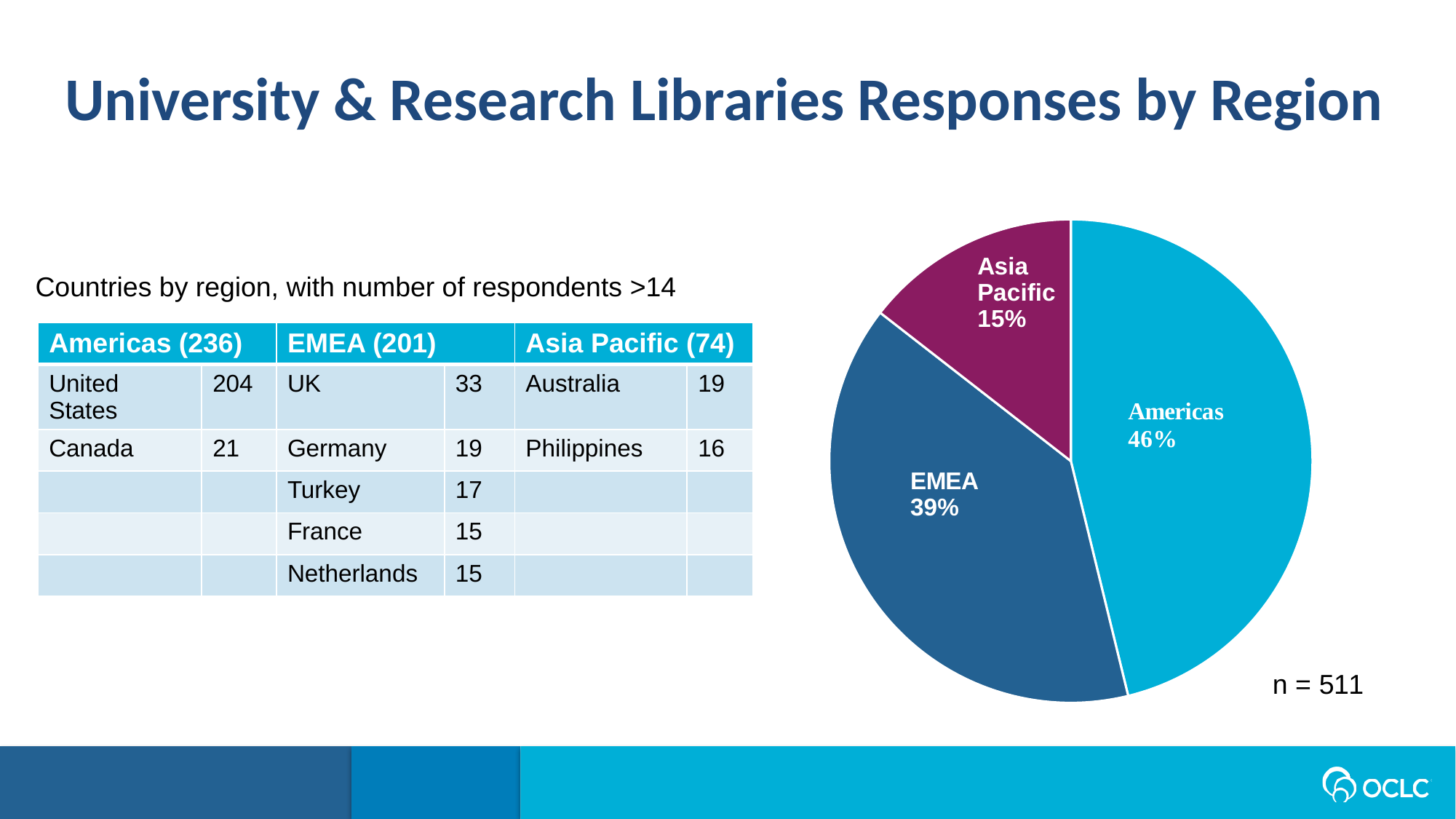
Which slice is larger, EMEA or Asia Pacific? EMEA What share of the pie chart does the Americas slice represent? 46% What share of the pie chart does Asia Pacific represent? 15% Which region has the largest slice in the pie chart? Americas What share of the pie chart does EMEA represent? 39% What colour is the Asia Pacific slice in the pie chart? Purple What is the difference in percentage points between the Americas and EMEA slices? 7 How many slices does the pie chart have? 3 What kind of chart is shown on the slide? Pie chart Which region has the smallest slice in the pie chart? Asia Pacific What is the total number of responses (n) noted next to the pie chart? n = 511 What is the difference in percentage points between the EMEA and Asia Pacific slices? 24